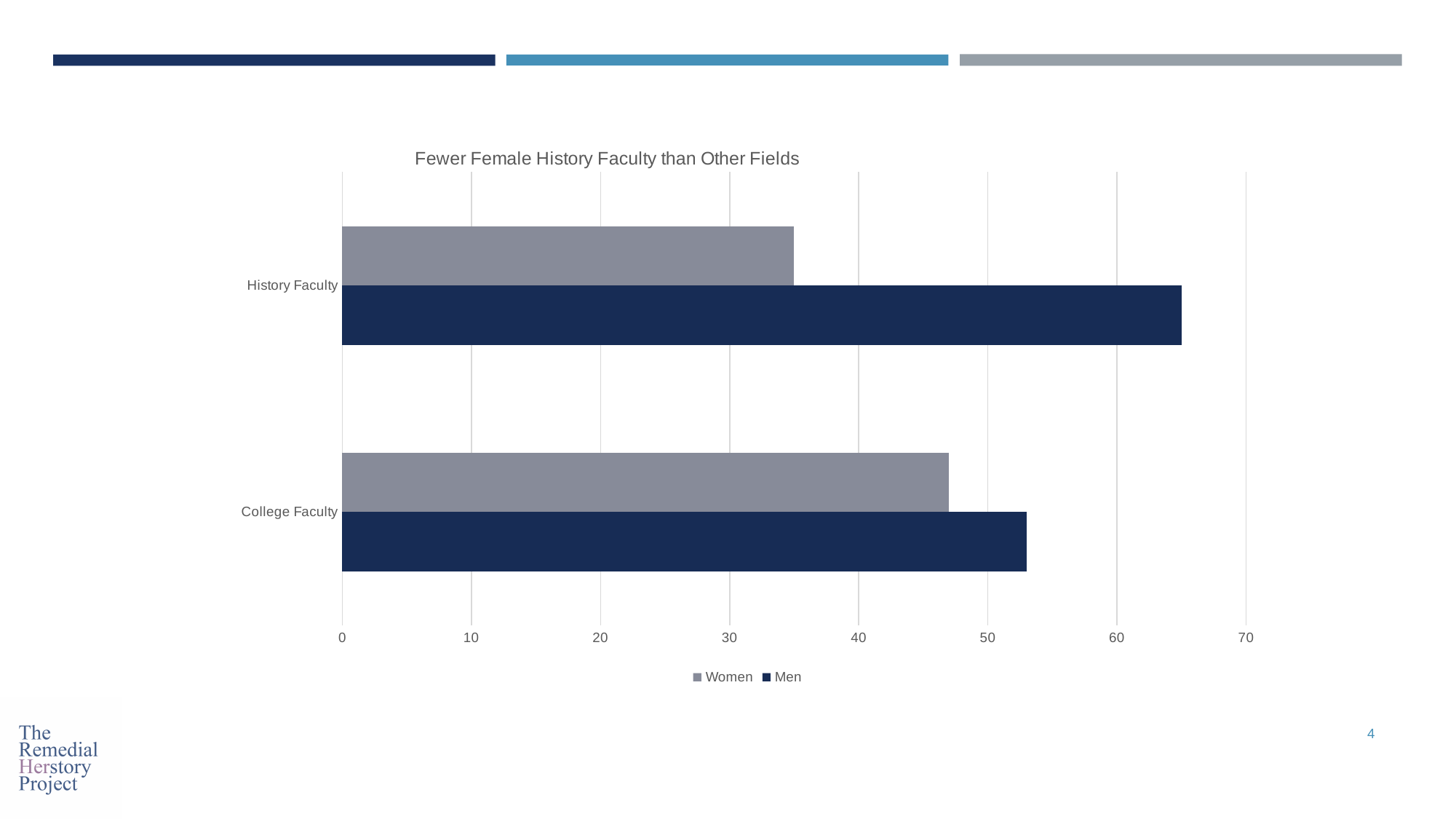
For History Faculty, which series has the larger value, Women or Men? Men Is the Women value for College Faculty greater or less than 50? less How many series does the legend list? 2 Which series is shown in gray? Women How many categories are shown on the vertical axis? 2 What kind of chart is shown on the slide? bar chart Is the Women value for History Faculty greater or less than 40? less Is the Men value for History Faculty greater or less than 60? greater Which category has the lower Men value? College Faculty What is the title of the chart? Fewer Female History Faculty than Other Fields Which category has the higher Women value? College Faculty